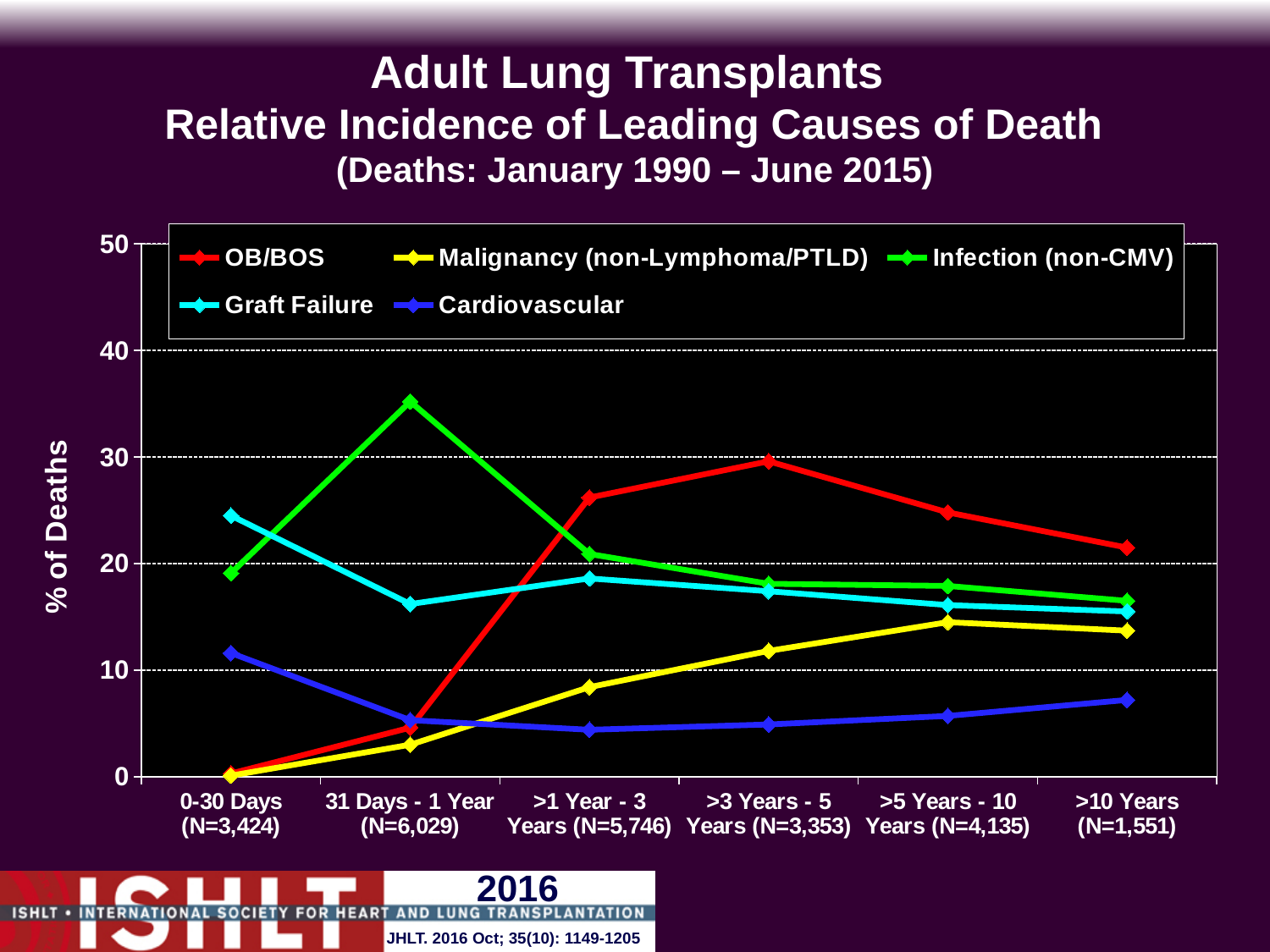
In the >10 Years period, which is larger: OB/BOS or Infection (non-CMV)? OB/BOS Is the value for Cardiovascular in the >10 Years period greater or less than 10? less What is the label on the y axis? % of Deaths Is the value for Graft Failure in the 0-30 Days period greater or less than 20? greater Which cause of death has the highest value in the 31 Days - 1 Year period? Infection (non-CMV) Is the value for Infection (non-CMV) in the 31 Days - 1 Year period greater or less than 30? greater Does the Malignancy (non-Lymphoma/PTLD) line rise or fall from 0-30 Days to >5 Years - 10 Years? rise How many series does the legend list? 5 Which cause of death has the highest value in the >3 Years - 5 Years period? OB/BOS What kind of chart is shown on the slide? line chart How many time periods are shown on the x axis? 6